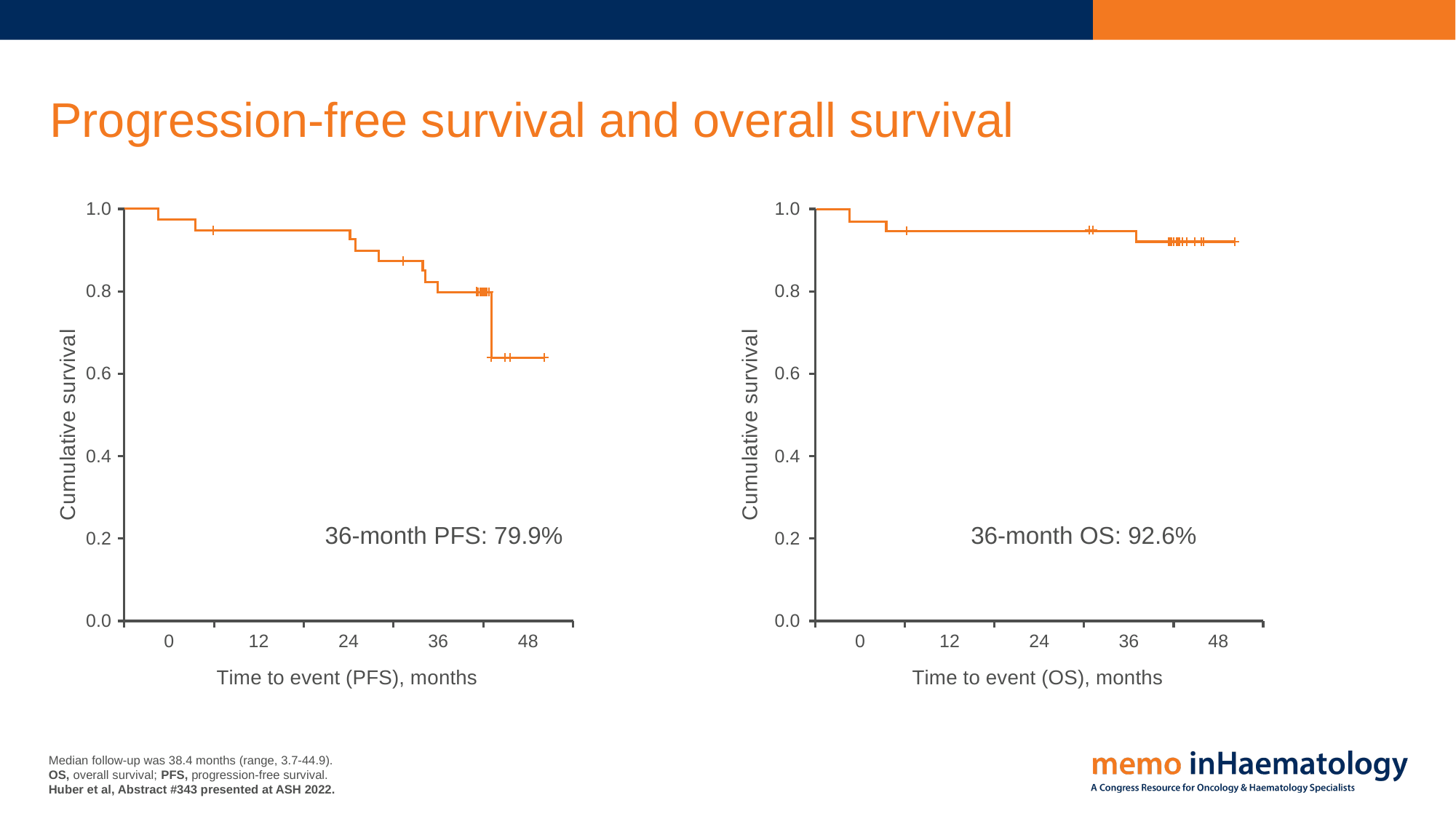
On the right chart, what is the 36-month OS rate printed on the slide? 92.6% How many charts are shown on the slide? 2 On the left chart, is the cumulative survival at 48 months greater or less than 0.8? less On the left chart, is the cumulative survival at 12 months greater or less than 0.8? greater What is the y-axis label of the left chart? Cumulative survival What kind of chart is shown on the left (Time to event (PFS))? Line chart (Kaplan-Meier survival curve) On the left chart, what is the 36-month PFS rate printed on the slide? 79.9% What is the x-axis label of the right chart? Time to event (OS), months On the right chart, is the cumulative survival at 48 months greater or less than 0.8? greater Which is higher, the 36-month PFS on the left chart or the 36-month OS on the right chart? 36-month OS On the left chart, does the cumulative survival curve rise or fall as time increases? Fall What is the difference in percentage points between the 36-month OS (right chart) and the 36-month PFS (left chart)? 12.7 percentage points